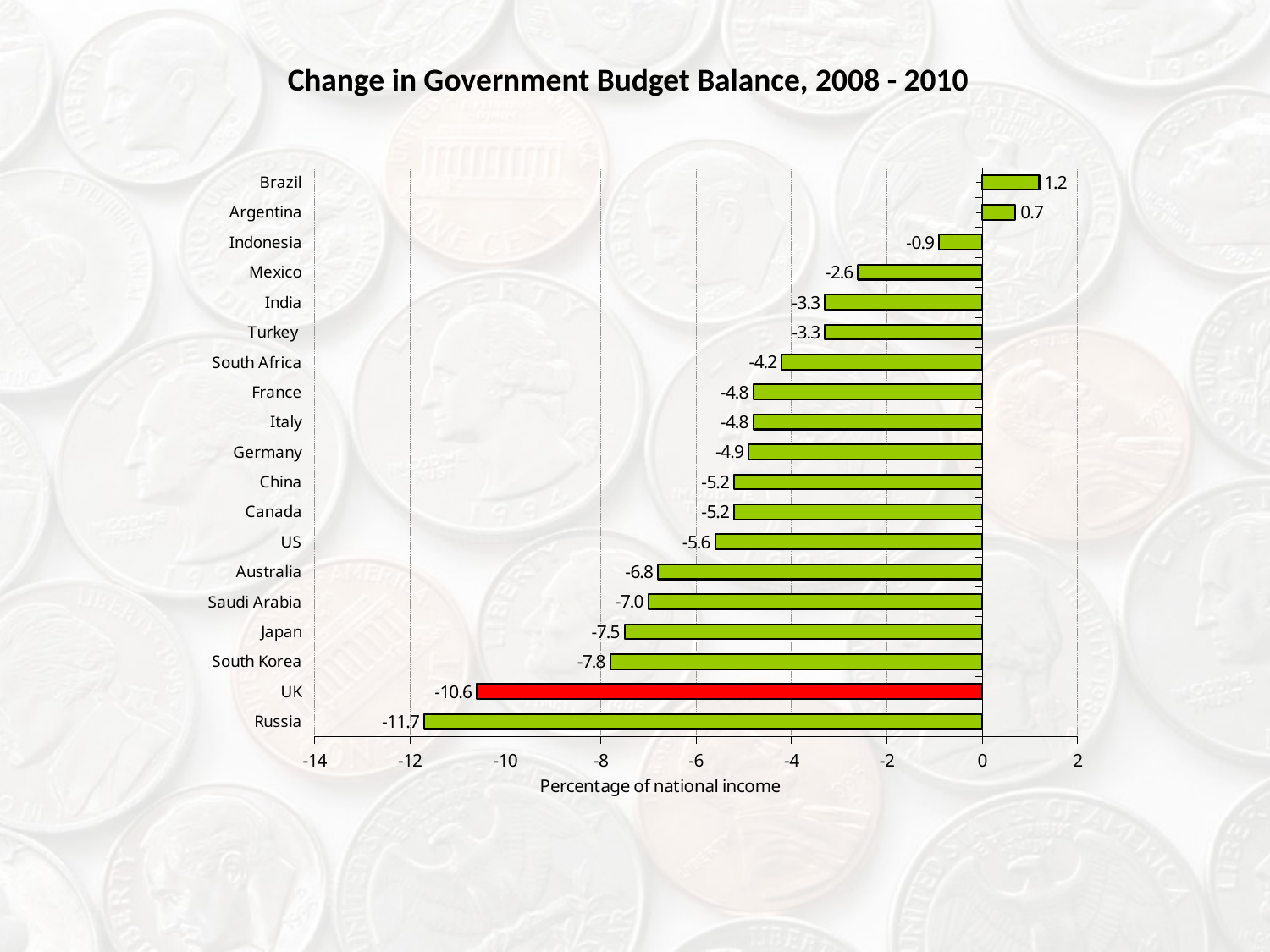
What is the title of the chart? Change in Government Budget Balance, 2008 - 2010 Which country's bar is coloured red? UK What is the x-axis label? Percentage of national income Which country has the lowest value? Russia Which country has the highest value? Brazil What is the value for Brazil? 1.2 What is the value for the UK? -10.6 What kind of chart is this? Bar chart What is the difference between the values for Russia and the UK? 1.1 How many countries are shown in the chart? 19 What is the value for Germany? -4.9 Which has the larger value, Japan or Australia? Australia